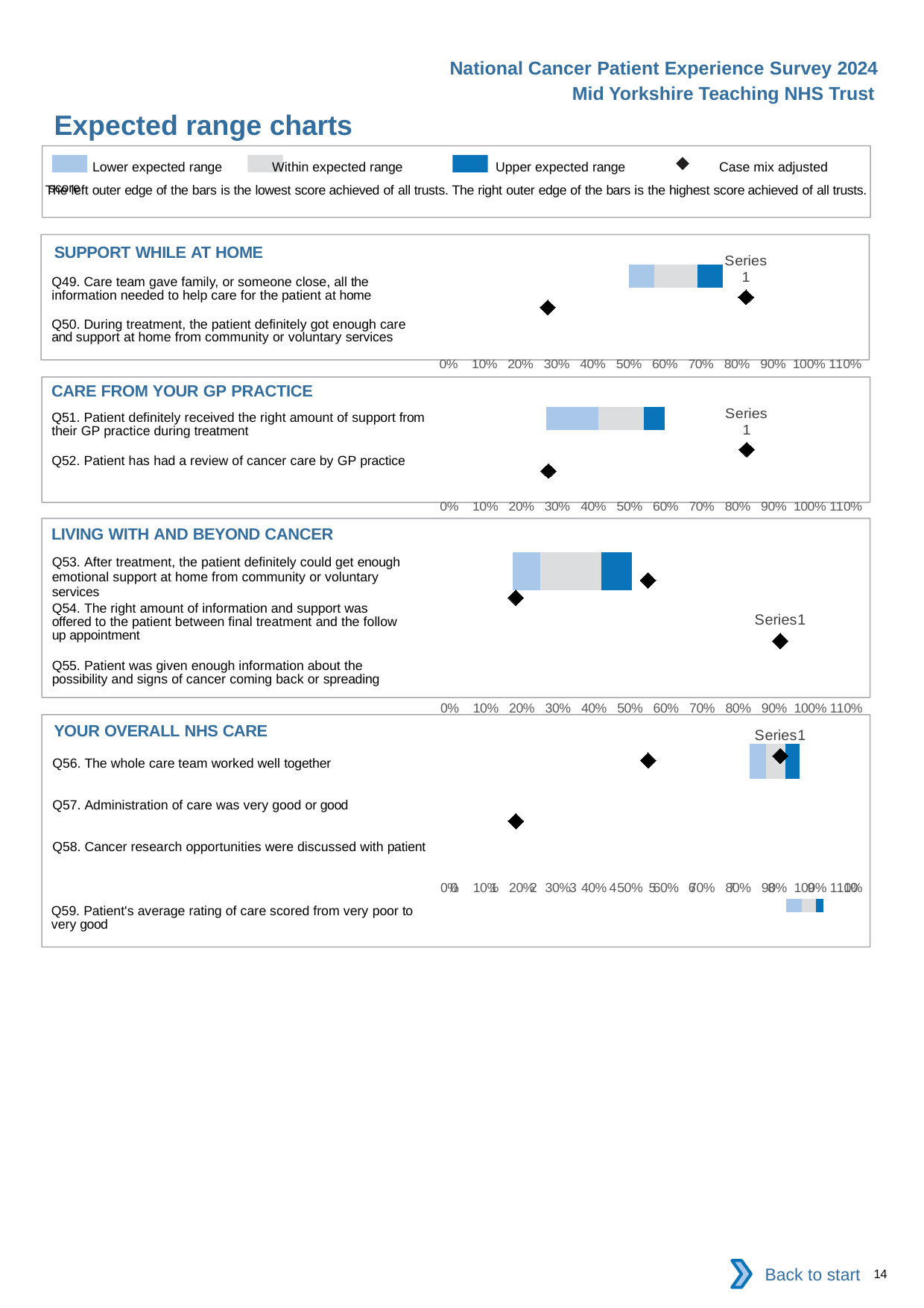
In the LIVING WITH AND BEYOND CANCER chart, is the rightmost diamond marker greater or less than 80%? greater In the CARE FROM YOUR GP PRACTICE chart, is the leftmost diamond marker greater or less than 40%? less What is the highest value shown on the x axis of the charts? 110% What kind of chart is used in the expected range charts on this slide? bar chart In the CARE FROM YOUR GP PRACTICE chart, is the rightmost diamond marker greater or less than 70%? greater How many entries does the legend at the top of the slide list? 4 How many questions are listed in the SUPPORT WHILE AT HOME chart? 2 What is the title of the slide? Expected range charts How many questions are listed in the YOUR OVERALL NHS CARE chart? 4 How many questions are listed in the LIVING WITH AND BEYOND CANCER chart? 3